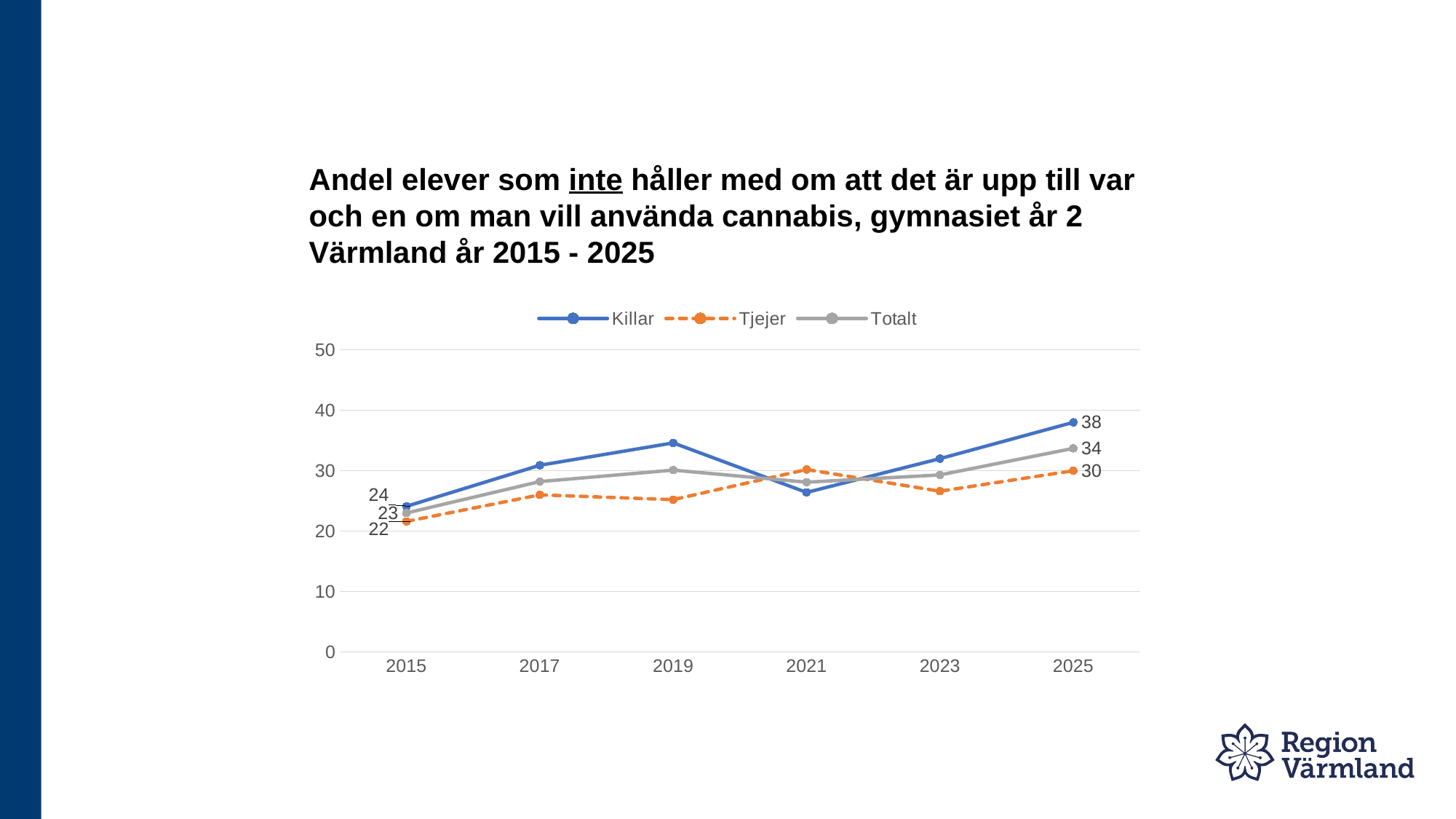
What kind of chart is shown on the slide? Line chart By how much did the value for Killar increase from 2015 to 2025? 14 How many series does the legend list? 3 Is the value for Tjejer in 2019 greater or less than 30? less Is the value for Killar in 2019 greater or less than 30? greater In which year does the Killar series reach its highest value? 2025 In 2025, which series has the larger value, Killar or Tjejer? Killar How many years are shown on the x axis? 6 What is the difference between Killar and Tjejer in 2025? 8 What is the value for Totalt in 2025? 34 What is the value for Tjejer in 2015? 22 What is the value for Killar in 2025? 38